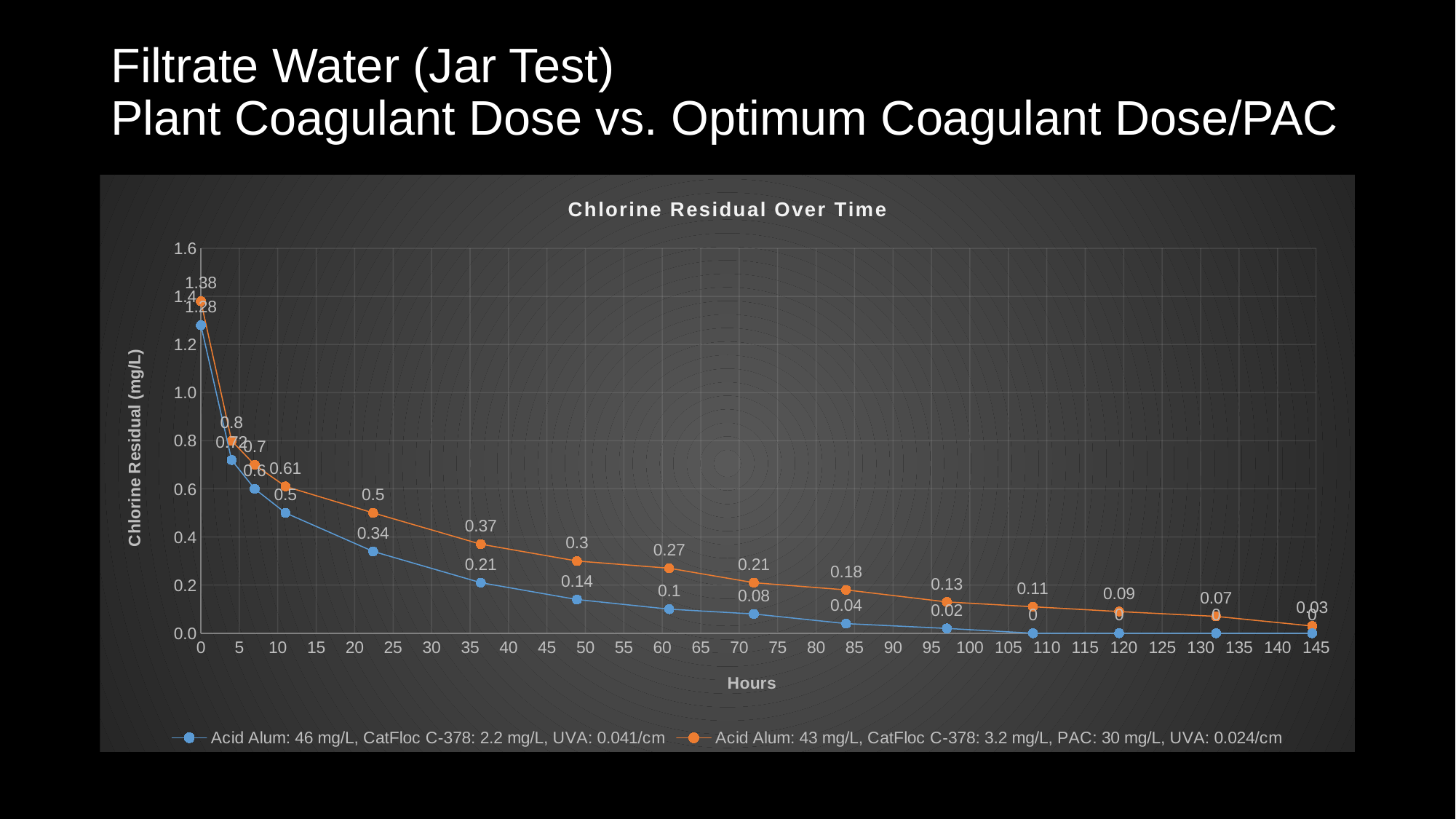
How many data points are plotted for each series? 15 Do the chlorine residual values rise or fall as hours increase? fall What kind of chart is shown on the slide? line chart What is the chlorine residual at 0 hours for the series 'Acid Alum: 43 mg/L, CatFloc C-378: 3.2 mg/L, PAC: 30 mg/L, UVA: 0.024/cm'? 1.38 What is the title of the vertical axis? Chlorine Residual (mg/L) What is the title of the horizontal axis? Hours What is the chlorine residual at 0 hours for the series 'Acid Alum: 46 mg/L, CatFloc C-378: 2.2 mg/L, UVA: 0.041/cm'? 1.28 What is the last plotted chlorine residual value for the non-PAC series (blue line)? 0 What is the last plotted chlorine residual value for the PAC series (orange line)? 0.03 At 0 hours, what is the difference between the chlorine residual of the PAC series and the non-PAC series? 0.1 How many series does the legend of the 'Chlorine Residual Over Time' chart list? 2 Which series starts with the higher chlorine residual at 0 hours? Acid Alum: 43 mg/L, CatFloc C-378: 3.2 mg/L, PAC: 30 mg/L, UVA: 0.024/cm